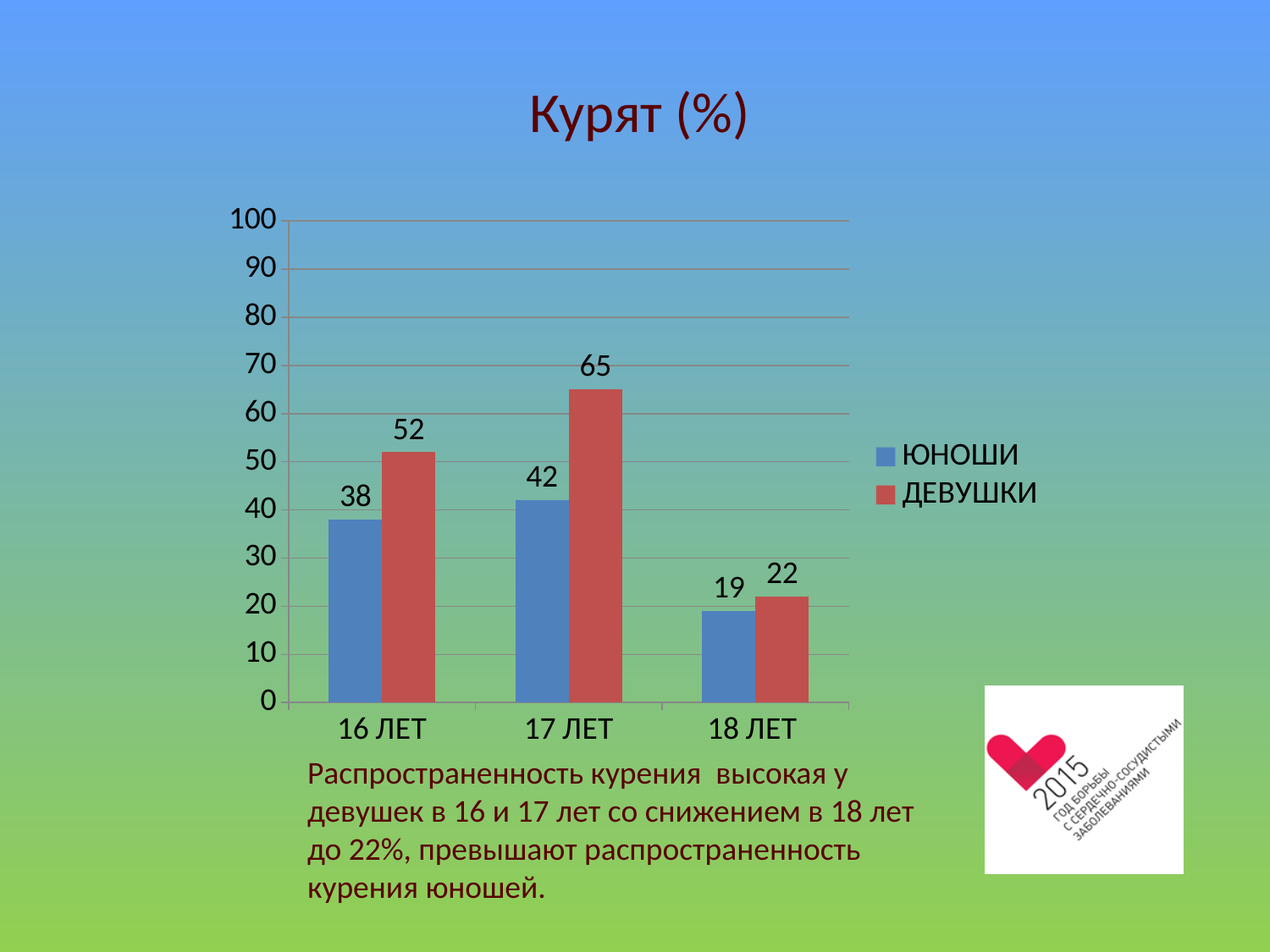
What kind of chart is shown on the slide? bar chart What is the difference between ДЕВУШКИ and ЮНОШИ at 17 ЛЕТ? 23 What is the value for ЮНОШИ at 16 ЛЕТ? 38 Is the value for ДЕВУШКИ at 18 ЛЕТ greater or less than 30? less What is the title of the chart? Курят (%) How many age categories are shown on the x axis? 3 Which is larger at 16 ЛЕТ, ЮНОШИ or ДЕВУШКИ? ДЕВУШКИ What is the value for ДЕВУШКИ at 17 ЛЕТ? 65 Which age group has the highest value for ДЕВУШКИ? 17 ЛЕТ Which age group has the lowest value for ЮНОШИ? 18 ЛЕТ What is the value for ЮНОШИ at 18 ЛЕТ? 19 How many series does the legend list? 2